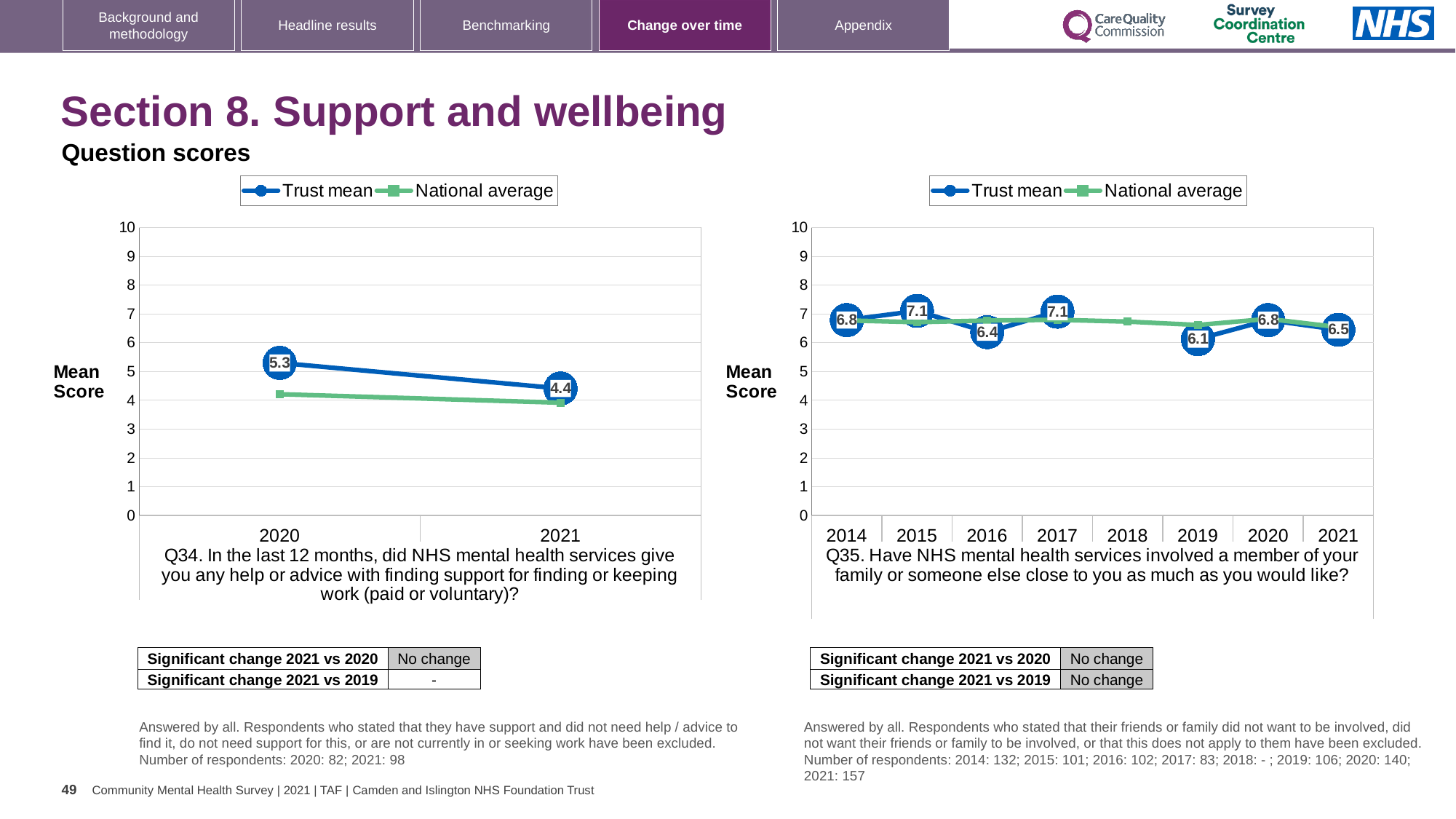
In the Q34 chart on the left, does the Trust mean rise or fall from 2020 to 2021? fall In the Q34 chart on the left, what is the Trust mean for 2021? 4.4 In the Q34 chart on the left, by how much did the Trust mean fall from 2020 to 2021? 0.9 In the Q35 chart on the right, is the Trust mean for 2016 larger or smaller than the Trust mean for 2017? smaller What type of chart is the Q34 chart on the left? line chart In the Q35 chart on the right, what is the Trust mean for 2019? 6.1 In the Q34 chart on the left, what is the Trust mean for 2020? 5.3 How many series does the legend of the Q35 chart on the right list? 2 In the Q35 chart on the right, what is the Trust mean for 2021? 6.5 In the Q35 chart on the right, which year has the lowest Trust mean? 2019 In the Q35 chart on the right, what is the difference between the Trust mean for 2015 and the Trust mean for 2016? 0.7 In the Q34 chart on the left, is the National average for 2020 greater or less than 5? less